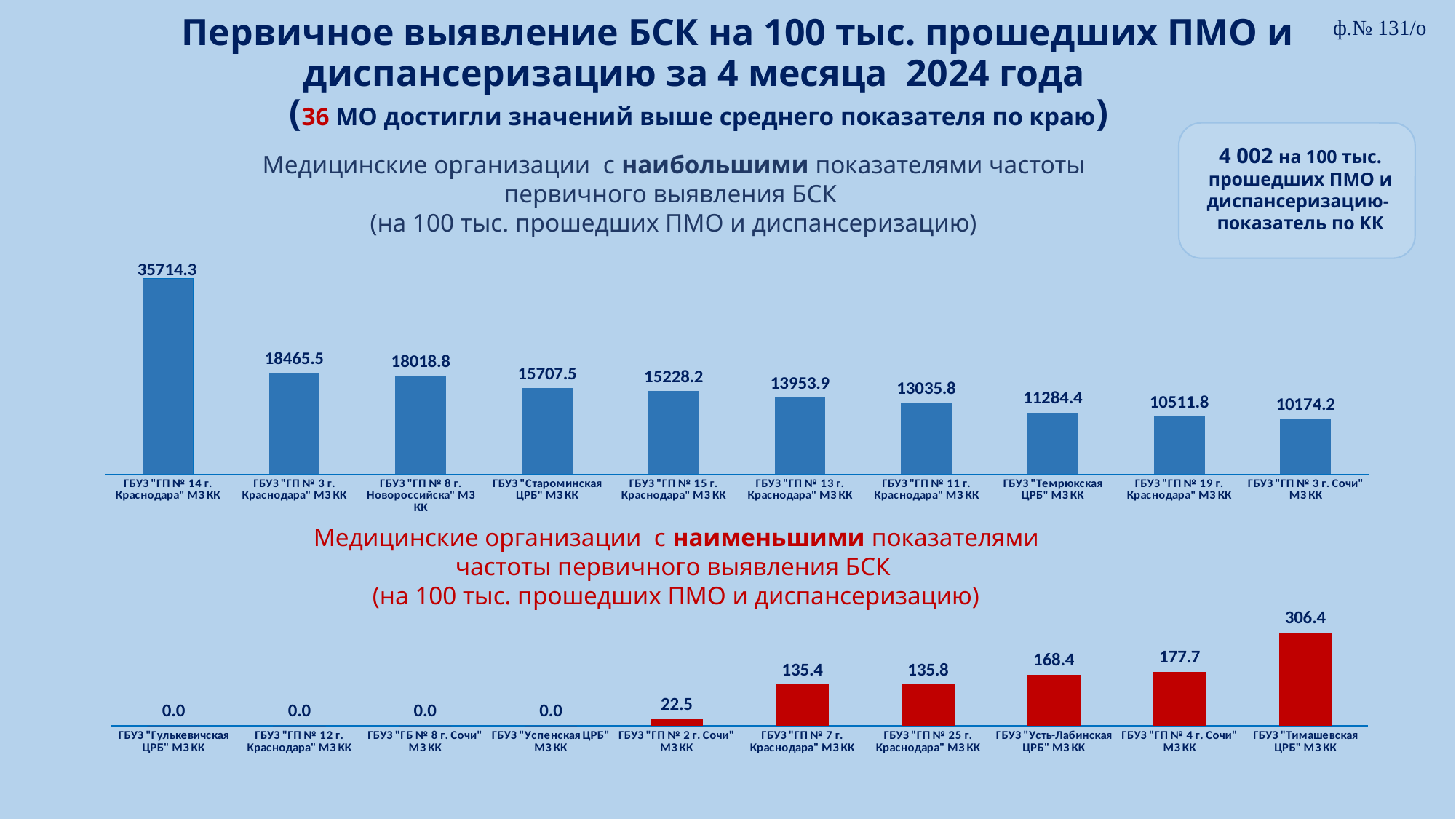
In the bottom chart (organizations with the lowest indicators), what is the value for ГБУЗ "Тимашевская ЦРБ" МЗ КК? 306.4 In the top chart, how many organizations are shown? 10 What type of chart is the bottom chart? bar chart In the bottom chart, which is larger: the value for ГБУЗ "Усть-Лабинская ЦРБ" МЗ КК or ГБУЗ "ГП № 4 г. Сочи" МЗ КК? ГБУЗ "ГП № 4 г. Сочи" МЗ КК In the bottom chart, how many organizations have a value of 0.0? 4 In the top chart, which organization has the lowest value? ГБУЗ "ГП № 3 г. Сочи" МЗ КК In the bottom chart, what is the value for ГБУЗ "ГП № 2 г. Сочи" МЗ КК? 22.5 In the top chart (organizations with the highest indicators), what is the value for ГБУЗ "ГП № 14 г. Краснодара" МЗ КК? 35714.3 In the top chart, what is the value for ГБУЗ "Темрюкская ЦРБ" МЗ КК? 11284.4 In the top chart, do the values rise or fall from left to right? fall In the top chart, what is the difference between the values for ГБУЗ "ГП № 3 г. Краснодара" МЗ КК and ГБУЗ "ГП № 8 г. Новороссийска" МЗ КК? 446.7 In the bottom chart, which organization has the highest value? ГБУЗ "Тимашевская ЦРБ" МЗ КК